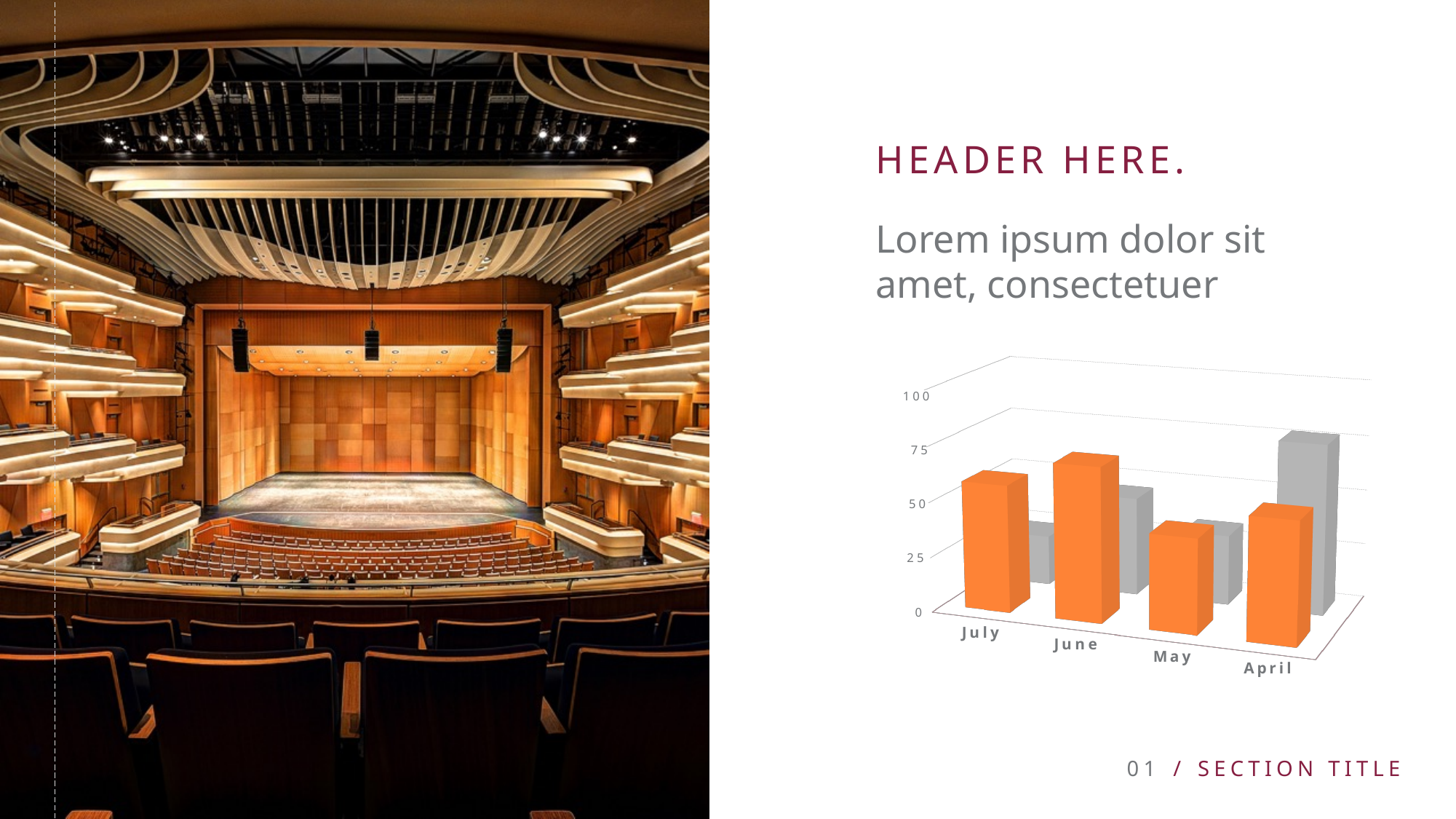
Which is larger, the orange bar for June or the orange bar for May? June What is the highest value labelled on the vertical axis of the chart? 100 What kind of chart is shown on the slide? bar chart How many series of bars are plotted in the chart? 2 Which category has the shortest orange bar? May For April, which bar is taller, the orange one or the gray one? the gray one Which category has the tallest gray bar? April Is the orange bar for July greater or less than 25? greater Is the orange bar for May greater or less than 75? less How many categories are shown on the x axis of the chart? 4 Which category has the tallest orange bar? June Is the gray bar for April greater or less than 50? greater